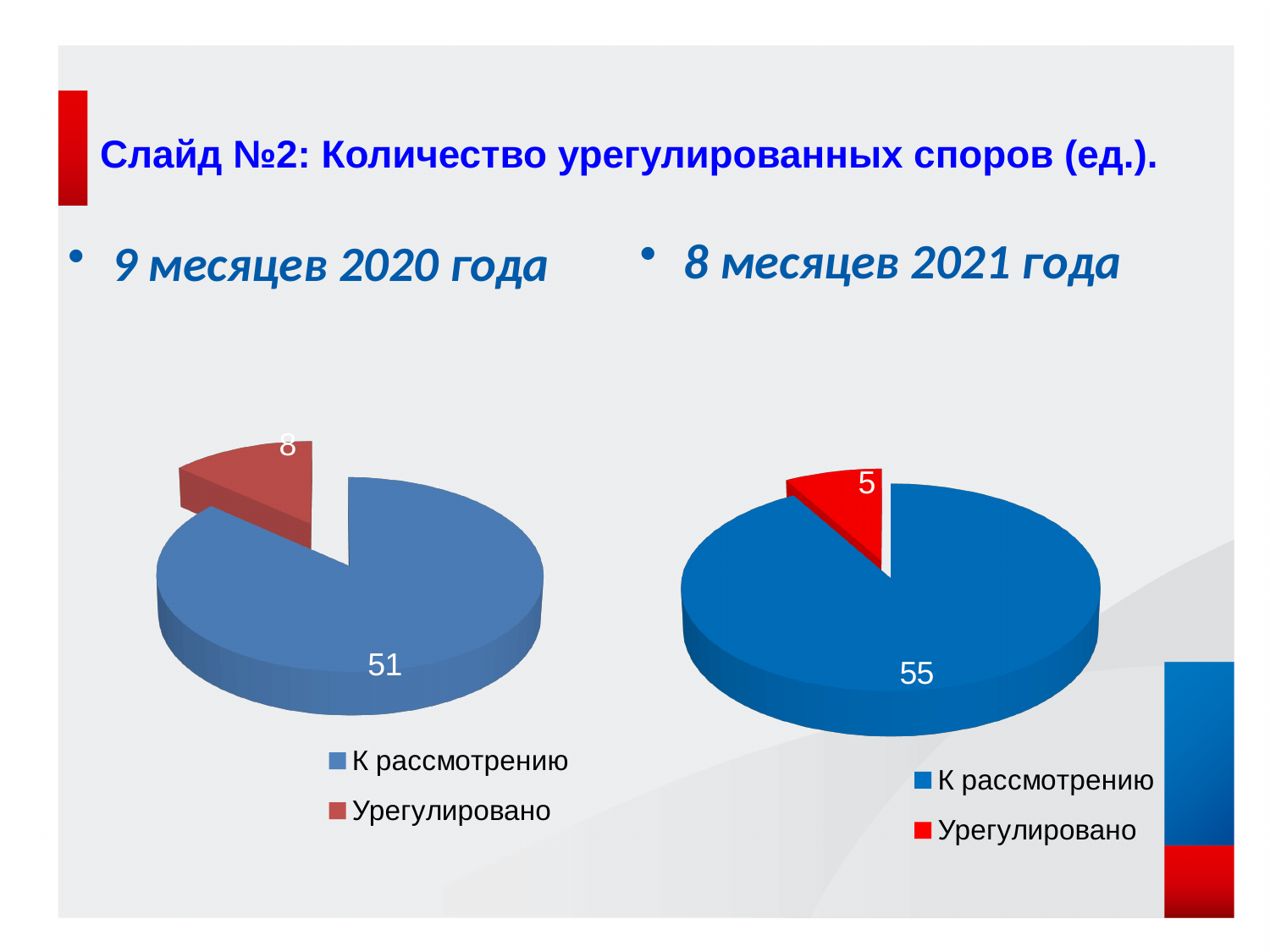
In the pie chart for 9 месяцев 2020 года, what is the difference between К рассмотрению and Урегулировано? 43 In the pie chart for 8 месяцев 2021 года, what is the difference between К рассмотрению and Урегулировано? 50 What type of chart is used for 9 месяцев 2020 года? Pie chart In the pie chart for 8 месяцев 2021 года, what is the value for Урегулировано? 5 Which is larger: К рассмотрению in the 9 месяцев 2020 года chart or К рассмотрению in the 8 месяцев 2021 года chart? 8 месяцев 2021 года What is the total of all slices in the pie chart for 8 месяцев 2021 года? 60 In the pie chart for 8 месяцев 2021 года, what is the value for К рассмотрению? 55 In the pie chart for 8 месяцев 2021 года, which category has the smallest slice? Урегулировано How many categories does the legend of the 8 месяцев 2021 года chart list? 2 In the pie chart for 9 месяцев 2020 года, which category has the largest slice? К рассмотрению In the pie chart for 9 месяцев 2020 года, what is the value for Урегулировано? 8 In the pie chart for 9 месяцев 2020 года, what is the value for К рассмотрению? 51